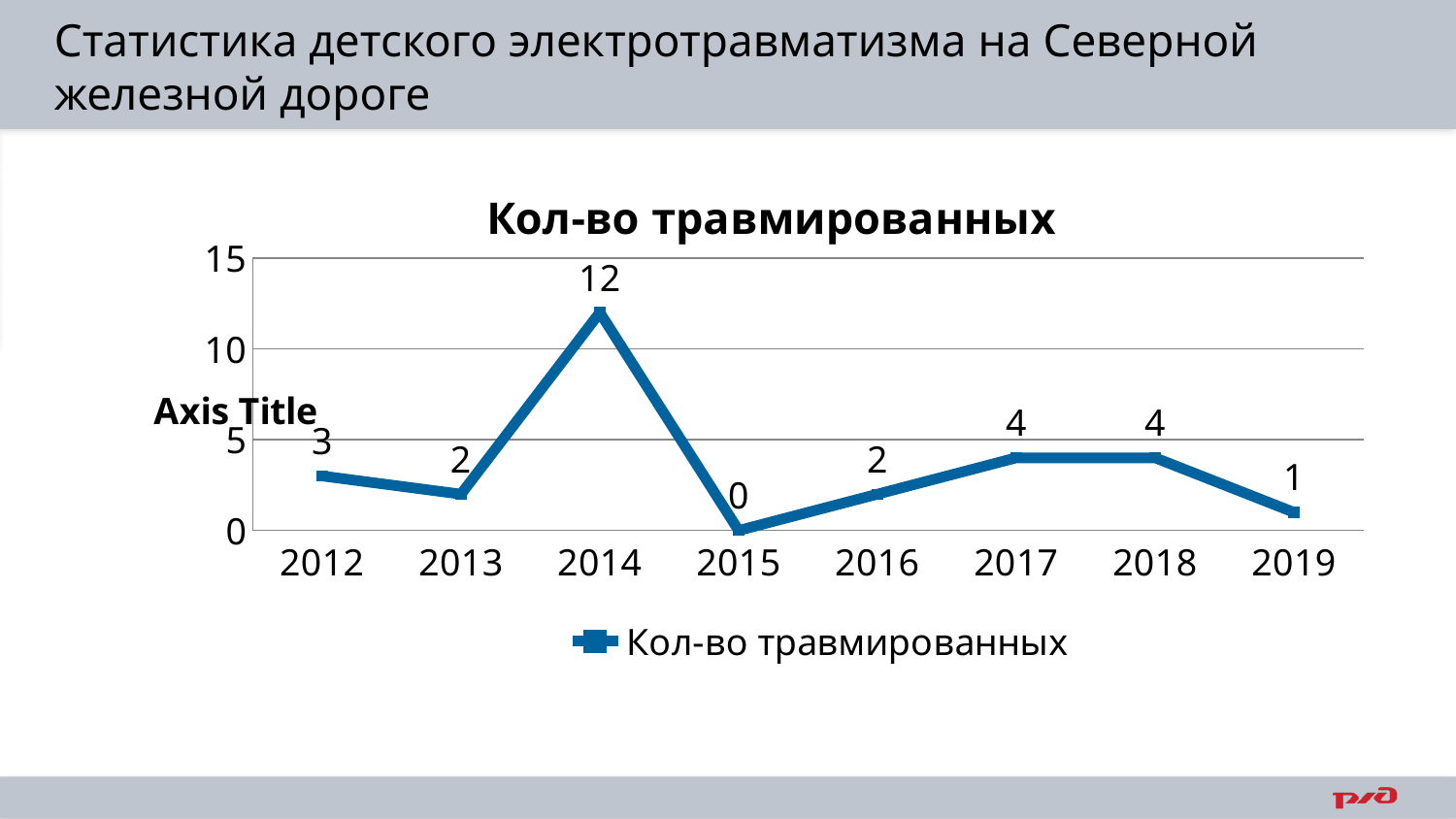
Which year has the highest value? 2014 How many years are shown on the x axis? 8 What is the title of the chart? Кол-во травмированных How many series does the legend list? 1 What kind of chart is this? line chart What is the value for 2019? 1 What is the value for 2012? 3 Which is larger, the value for 2017 or the value for 2019? 2017 Which year has the lowest value? 2015 What is the value for 2014? 12 What is the difference between the values for 2014 and 2013? 10 Is the value for 2014 greater or less than 10? greater